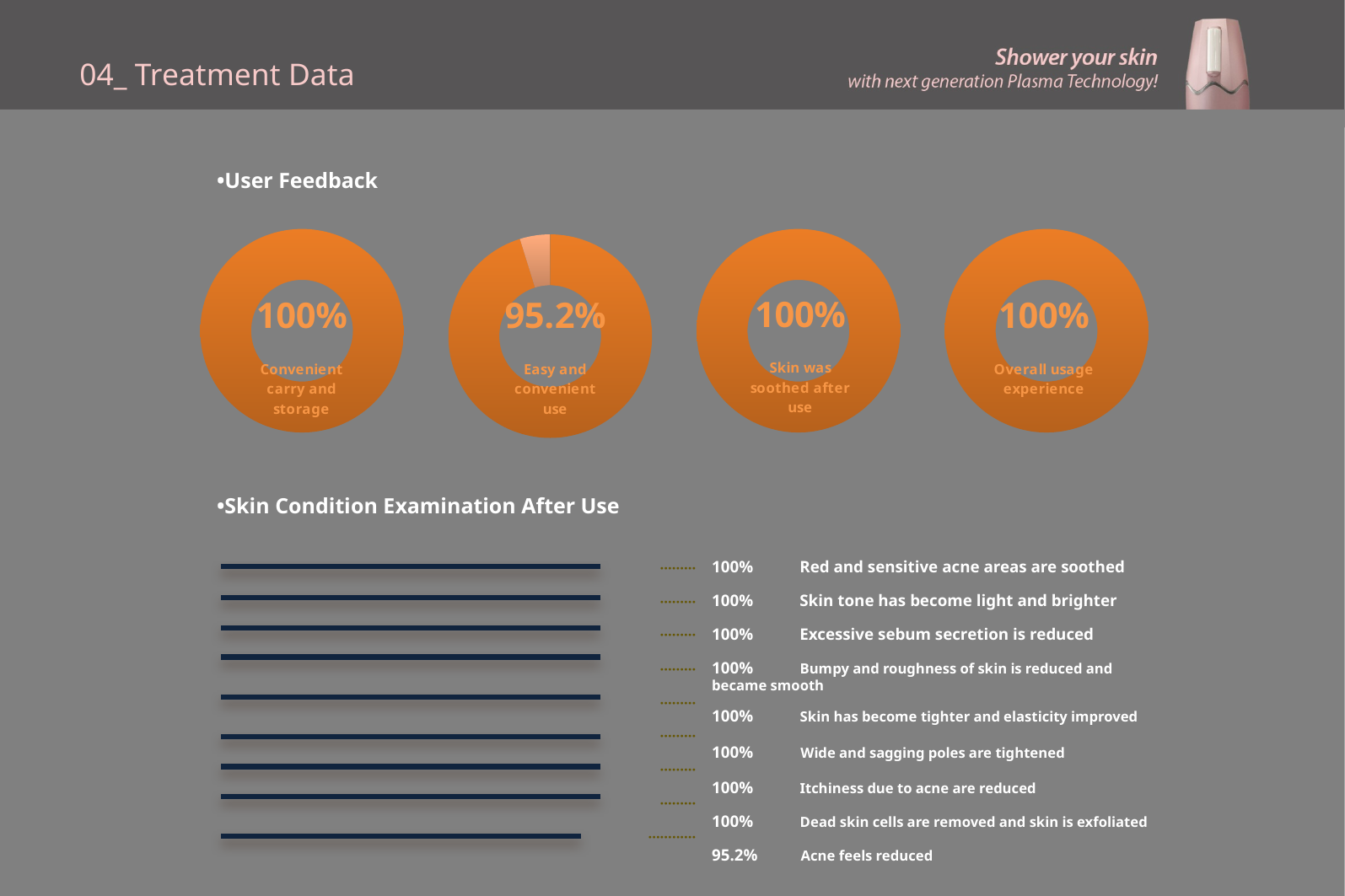
In the Skin Condition Examination After Use chart, what percentage is shown for "Excessive sebum secretion is reduced"? 100% In the Skin Condition Examination After Use chart, what is the difference between "Red and sensitive acne areas are soothed" and "Acne feels reduced"? 4.8% How many bars are in the Skin Condition Examination After Use chart? 9 In the User Feedback donut charts, which item has the lowest percentage? Easy and convenient use What kind of chart is used in the Skin Condition Examination After Use section? Bar chart In the Skin Condition Examination After Use chart, what percentage is shown for "Acne feels reduced"? 95.2% In the User Feedback donut charts, what percentage is shown for "Easy and convenient use"? 95.2% What kind of chart is used in the User Feedback section? Donut (pie) chart In the User Feedback donut charts, which is larger: "Skin was soothed after use" or "Easy and convenient use"? Skin was soothed after use In the User Feedback donut charts, what percentage is shown for "Convenient carry and storage"? 100% In the Skin Condition Examination After Use chart, which item has the lowest percentage? Acne feels reduced How many donut charts are shown in the User Feedback section? 4